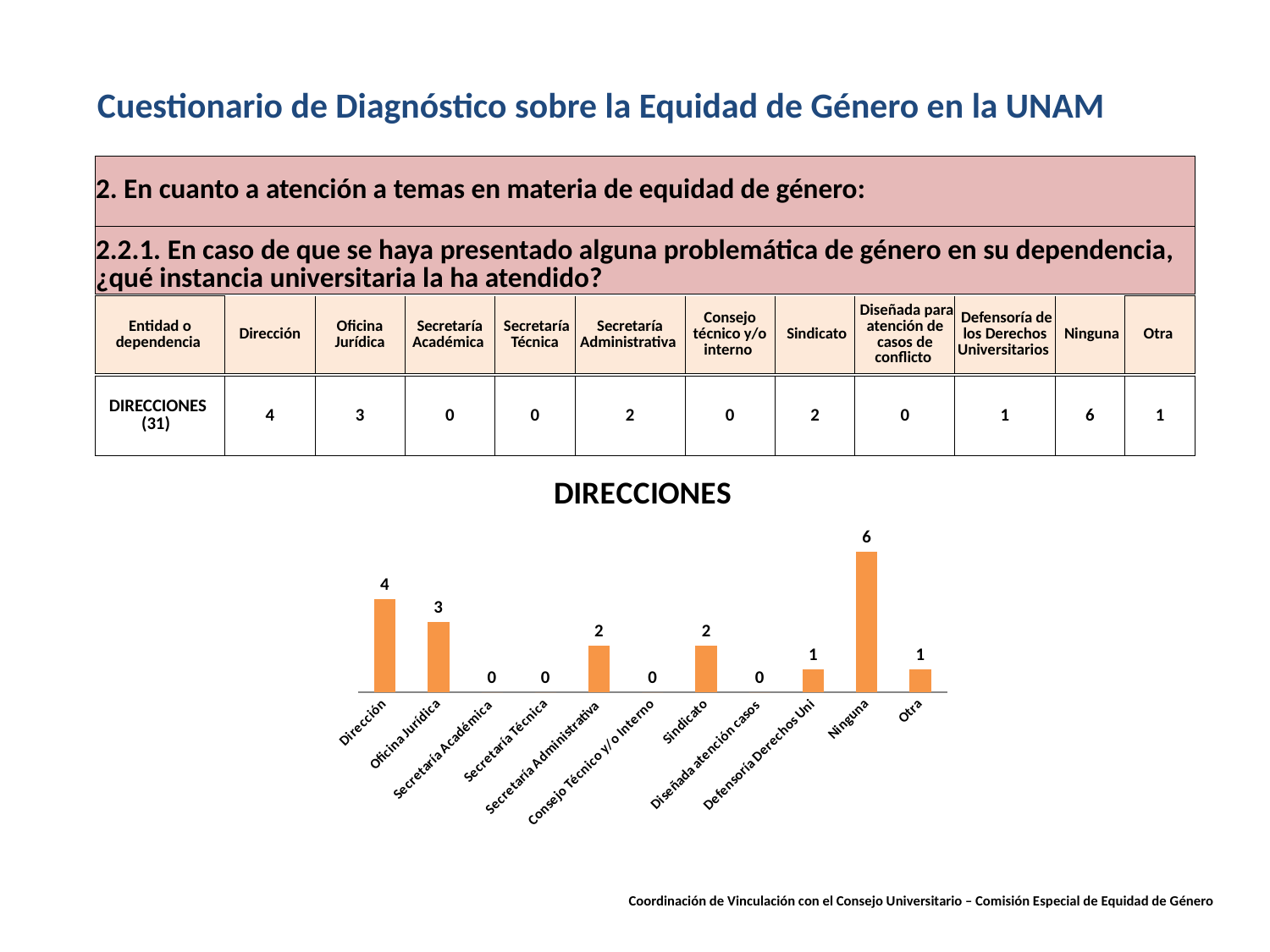
What is the value for Ninguna in the DIRECCIONES chart? 6 What is the value for Sindicato in the DIRECCIONES chart? 2 Which category has the highest value in the DIRECCIONES chart? Ninguna How many categories in the DIRECCIONES chart have a value of 0? 4 Which is larger in the DIRECCIONES chart, Dirección or Oficina Jurídica? Dirección What is the title of the chart on the slide? DIRECCIONES What is the value for Defensoría Derechos Uni in the DIRECCIONES chart? 1 What is the difference between the values for Ninguna and Dirección in the DIRECCIONES chart? 2 How many categories are shown on the x axis of the DIRECCIONES chart? 11 What kind of chart is the DIRECCIONES chart? bar chart What is the value for Dirección in the DIRECCIONES chart? 4 What is the value for Oficina Jurídica in the DIRECCIONES chart? 3